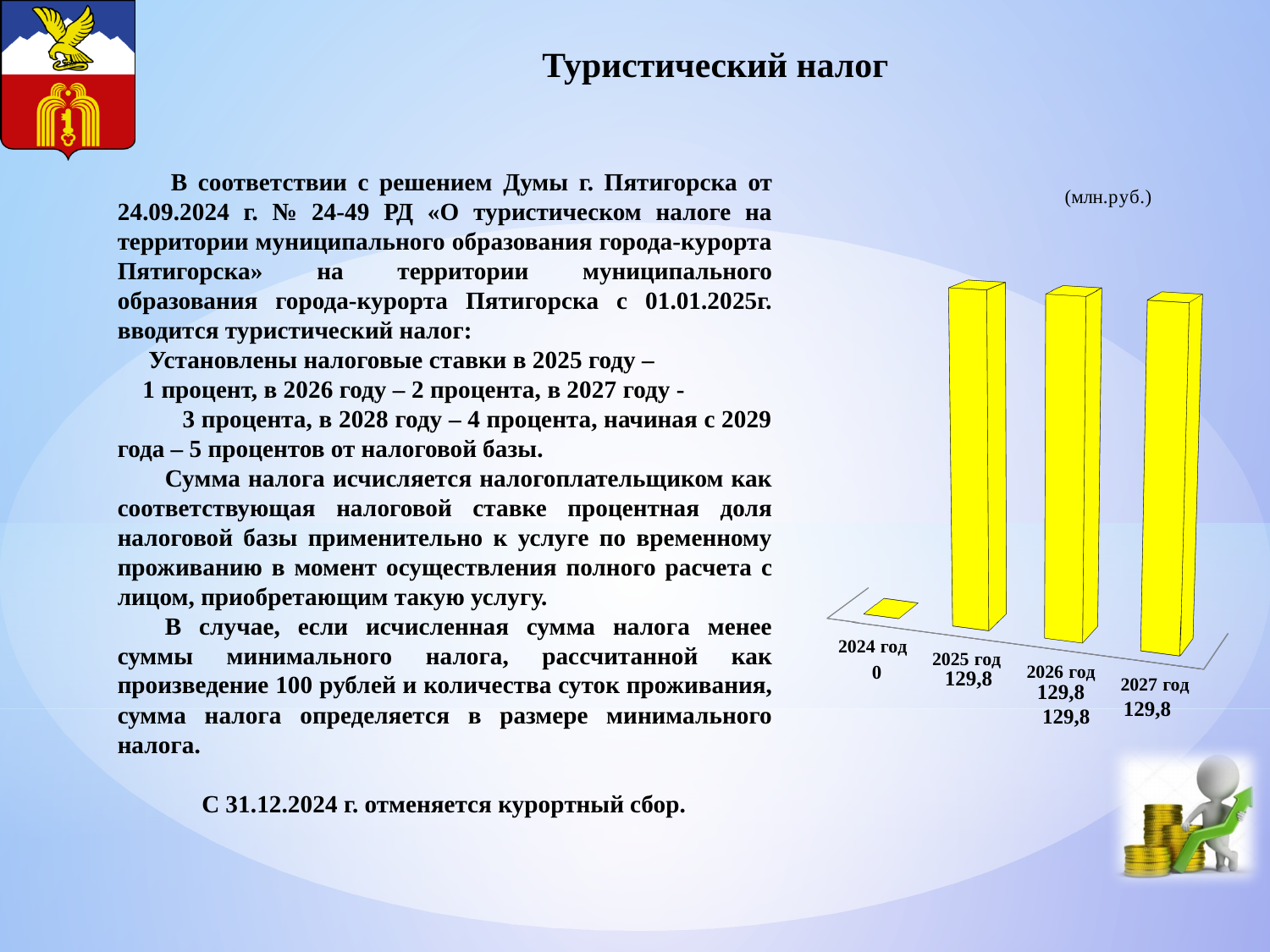
Which year has the lowest value on the chart? 2024 год What is the value for 2025 год on the chart? 129,8 What is the value for 2024 год on the chart? 0 In what units are the chart values given, according to the label above the chart? млн.руб. What is the value for 2026 год on the chart? 129,8 What colour are the bars on the chart? yellow How many years (categories) are shown on the chart? 4 What is the difference between the values for 2025 год and 2024 год? 129,8 What kind of chart is shown on the slide? bar chart What is the value for 2027 год on the chart? 129,8 Which is larger, the value for 2025 год or the value for 2024 год? 2025 год